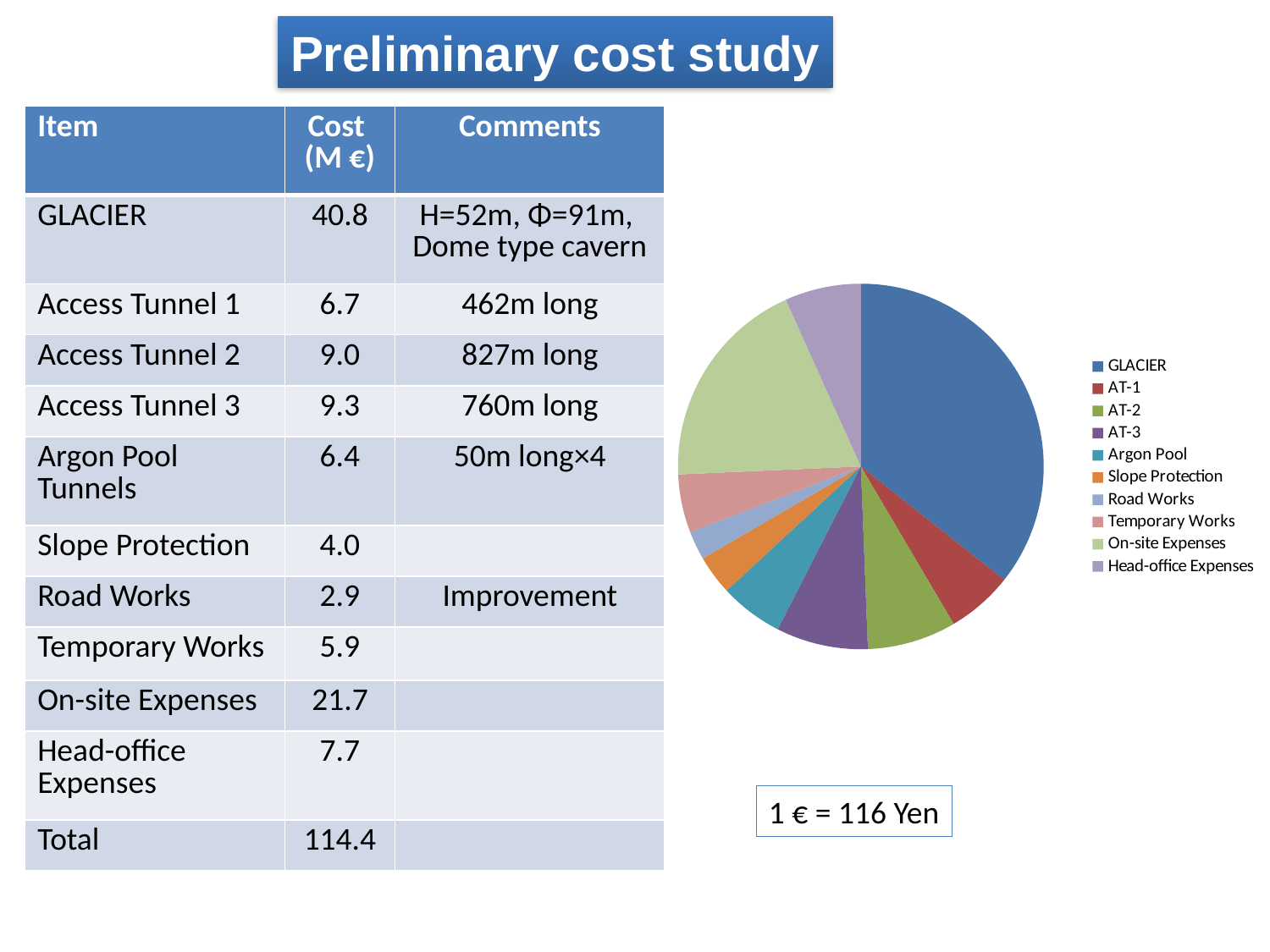
How many entries does the pie chart's legend list? 10 In the pie chart, which slice is larger: On-site Expenses or Head-office Expenses? On-site Expenses Which category has the largest slice in the pie chart? GLACIER Which legend entry is listed first in the pie chart's legend? GLACIER What colour is the GLACIER slice in the pie chart? Blue In the pie chart, which slice is larger: AT-3 or Argon Pool? AT-3 Which category has the second-largest slice in the pie chart? On-site Expenses How many slices does the pie chart have? 10 Which category has the smallest slice in the pie chart? Road Works In the pie chart, which slice is larger: Temporary Works or Road Works? Temporary Works What kind of chart is shown on the slide? Pie chart